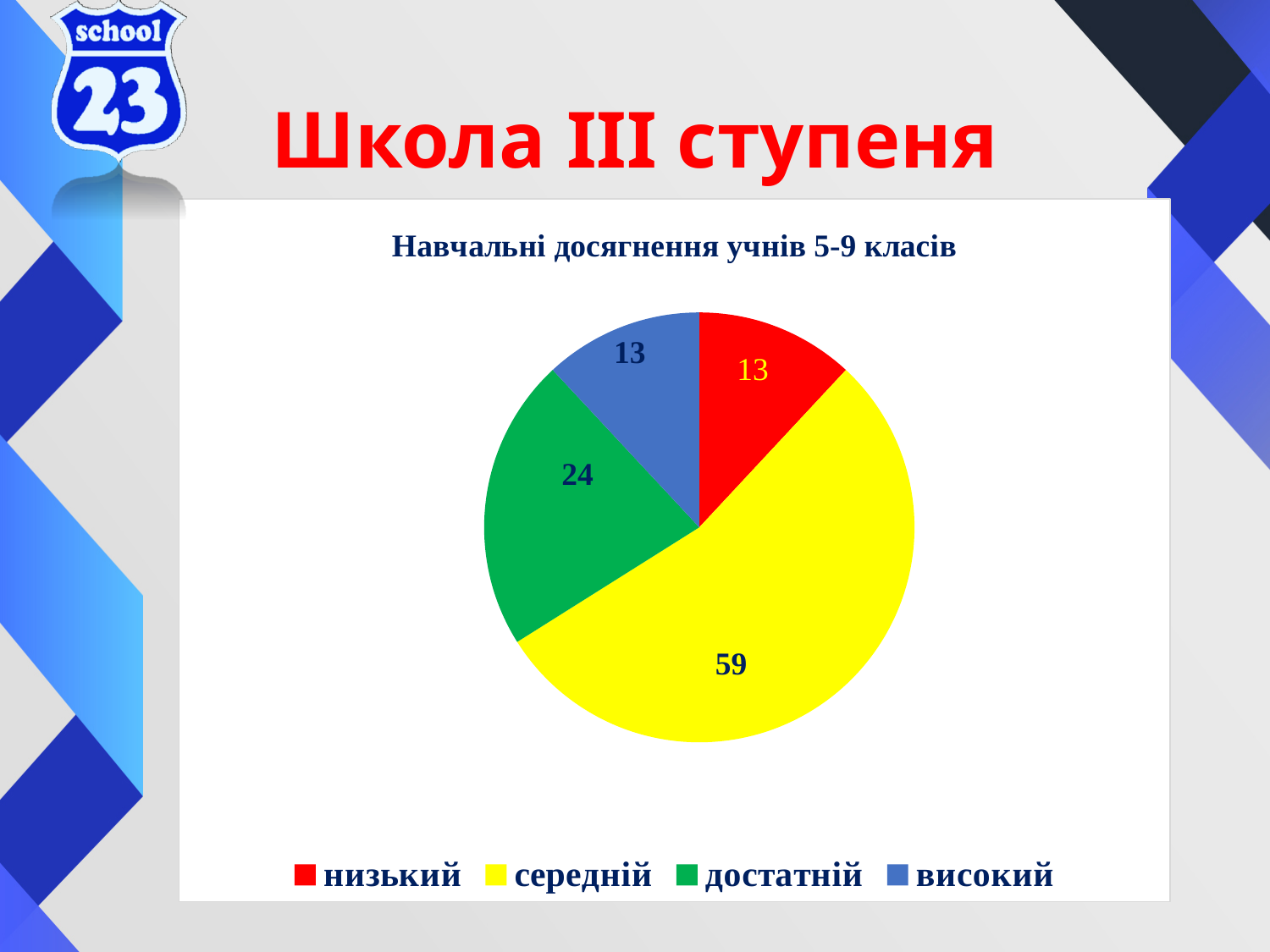
What is the difference between the values for середній and достатній? 35 Which is larger, the value for достатній or the value for високий? достатній How many categories does the legend list? 4 What is the value for середній? 59 What is the difference between the values for достатній and високий? 11 What is the value for низький? 13 What is the title of the chart? Навчальні досягнення учнів 5-9 класів What is the value for високий? 13 What is the value for достатній? 24 Which category has the largest slice of the pie? середній What colour is the slice for середній? yellow What type of chart is shown on the slide? pie chart